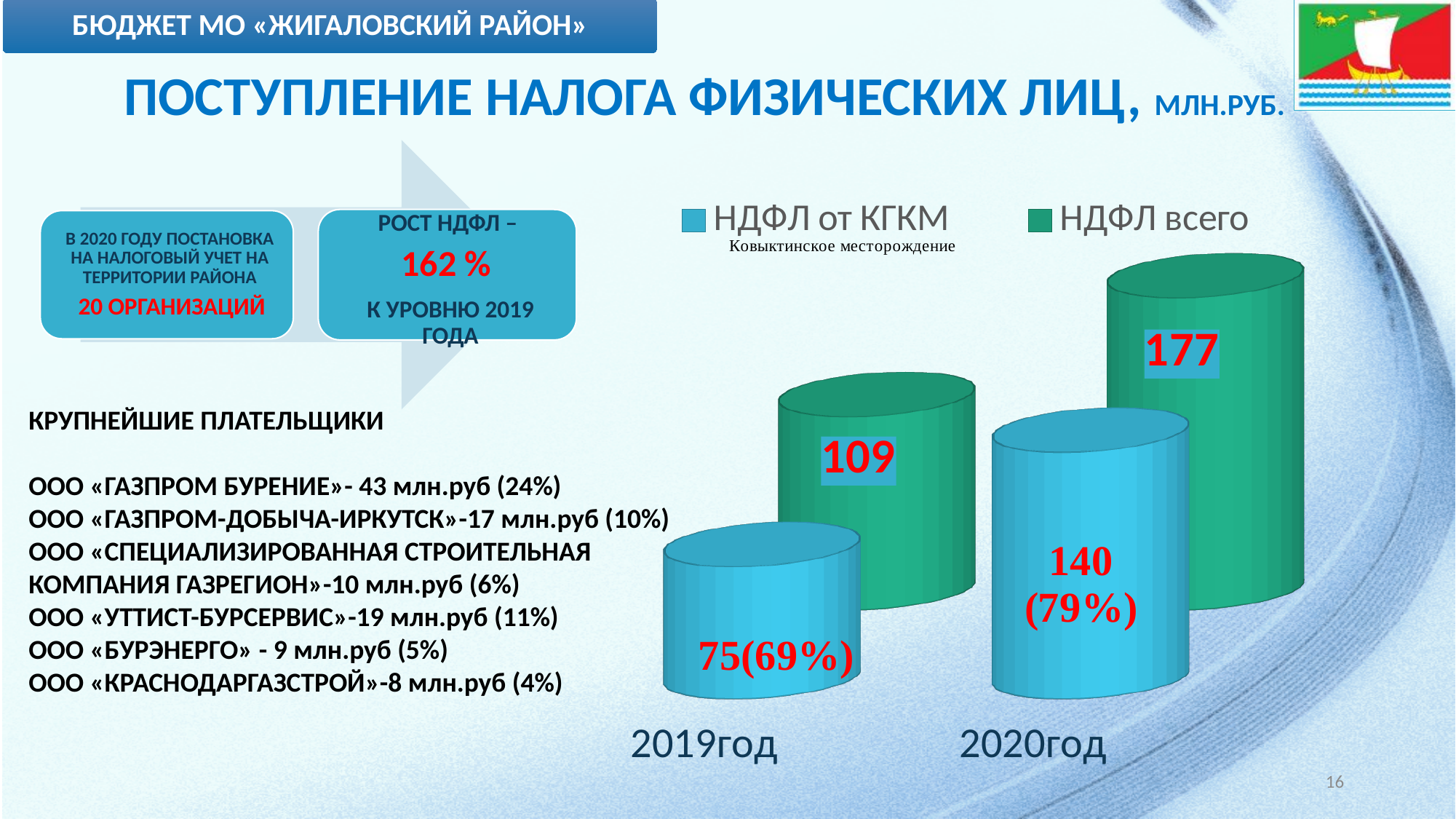
What is the value of НДФЛ от КГКМ for 2020год? 140 How many series does the chart legend list? 2 Which year has the higher value for НДФЛ от КГКМ, 2019год or 2020год? 2020год What is the value of НДФЛ всего for 2020год? 177 What is the value of НДФЛ от КГКМ for 2019год? 75 By how much did НДФЛ всего increase from 2019год to 2020год? 68 What percentage is shown next to the НДФЛ от КГКМ value for 2019год? 69% What is the difference between НДФЛ всего and НДФЛ от КГКМ in 2020год? 37 What percentage is shown next to the НДФЛ от КГКМ value for 2020год? 79% What is the value of НДФЛ всего for 2019год? 109 What colour represents the НДФЛ всего series in the chart? green Do the НДФЛ всего values rise or fall from 2019год to 2020год? rise